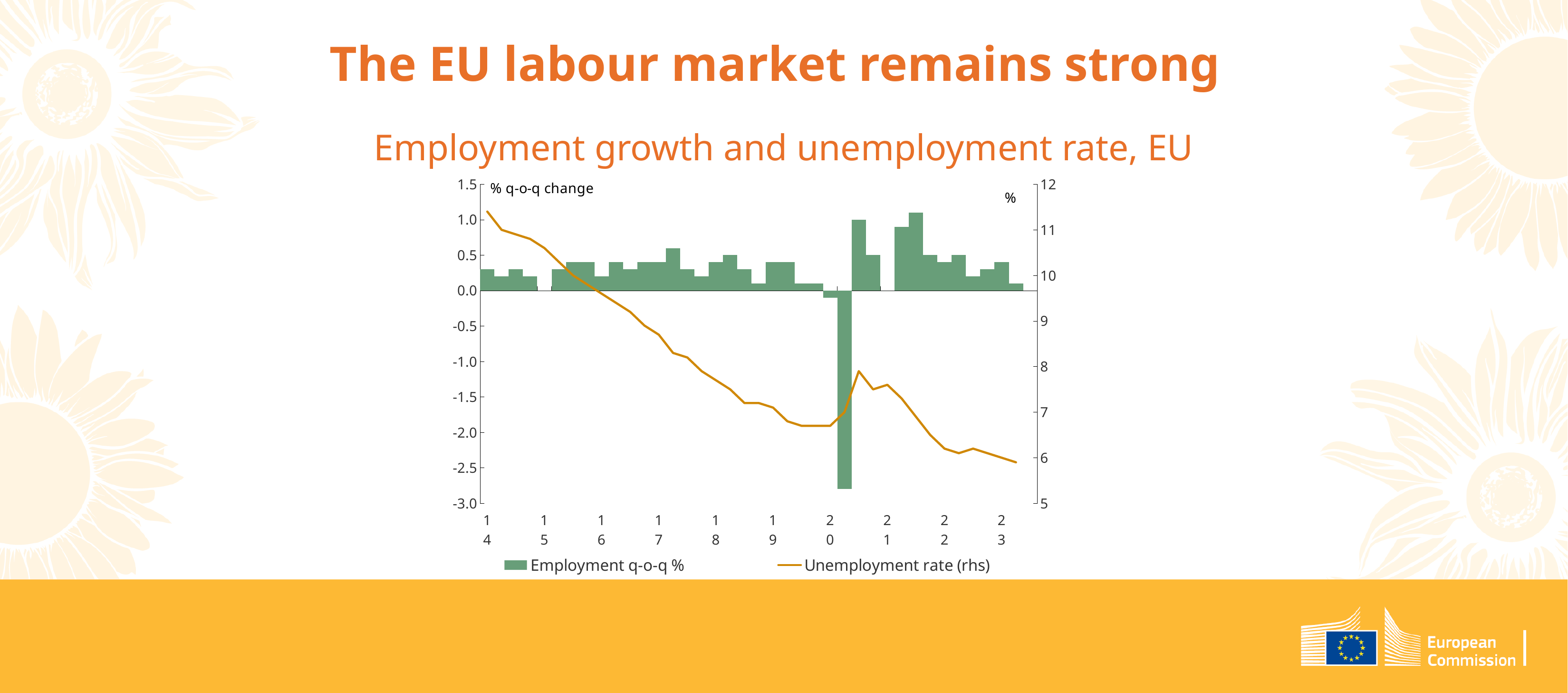
Is the unemployment rate at the end of 2023 greater or less than 7%? less What are the two series named in the legend? Employment q-o-q % and Unemployment rate (rhs) Does the unemployment rate line rise or fall between 2021 and 2023? Fall Does the unemployment rate line rise or fall between 2014 and 2019? Fall What kind of chart is shown on the slide? A combined bar and line chart Is the unemployment rate at the start of 2014 greater or less than 11%? greater In which year does the employment q-o-q % series show its lowest bar? 2020 What is the title of the chart? Employment growth and unemployment rate, EU Is the highest employment q-o-q bar greater or less than 0.5? greater How many year labels are shown on the x axis? 10 How many series does the chart legend list? 2